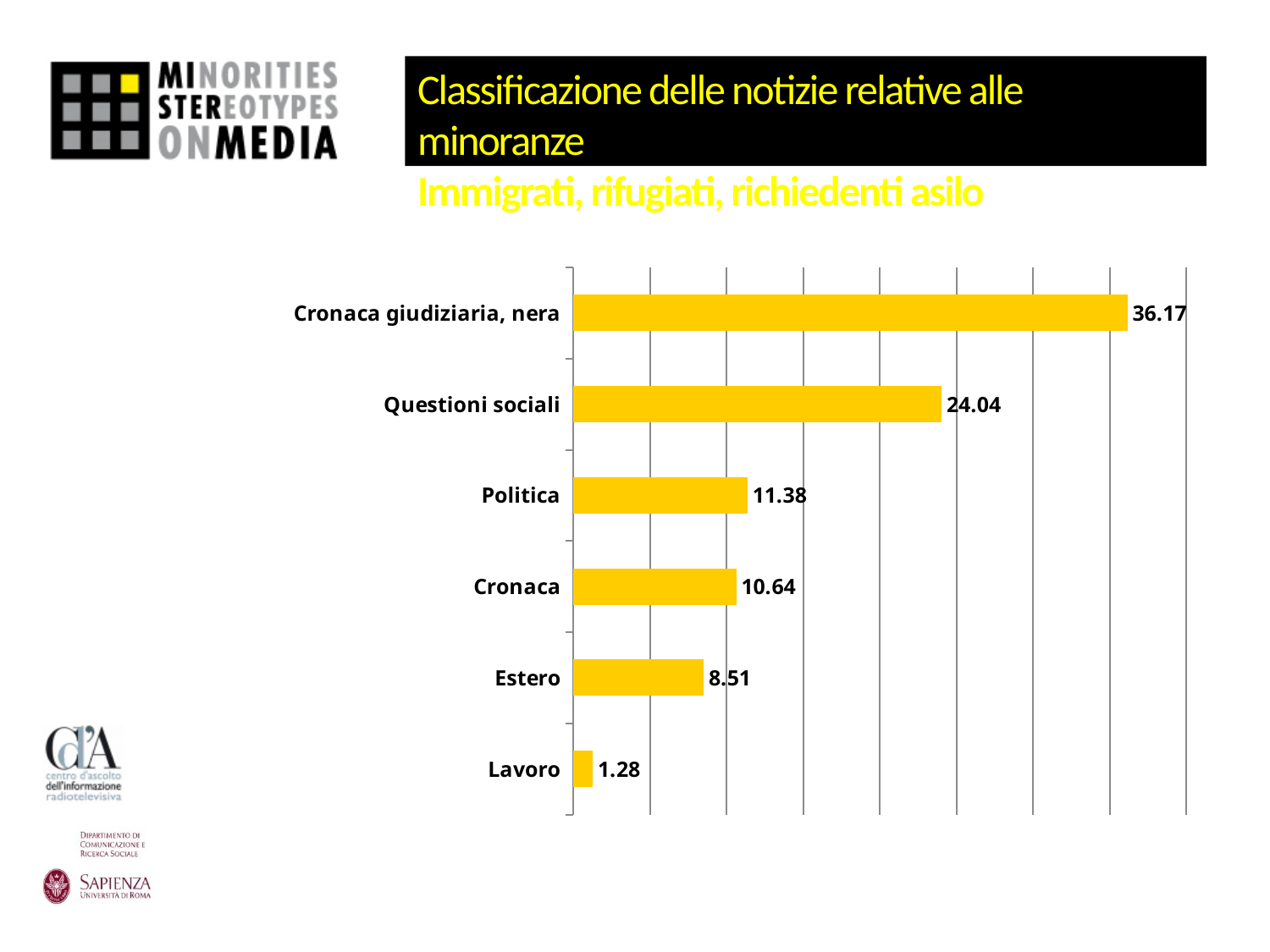
What is the value for Politica? 11.38 What is the difference between the values for Cronaca giudiziaria, nera and Questioni sociali? 12.13 Which category has the highest value? Cronaca giudiziaria, nera Which category has the lowest value? Lavoro What is the difference between the values for Politica and Cronaca? 0.74 What is the value for Questioni sociali? 24.04 What colour are the bars in the chart? Yellow Which is larger, the value for Cronaca or the value for Estero? Cronaca What is the value for Estero? 8.51 What is the value for Cronaca giudiziaria, nera? 36.17 What kind of chart is shown on the slide? Bar chart How many categories are shown in the chart? 6